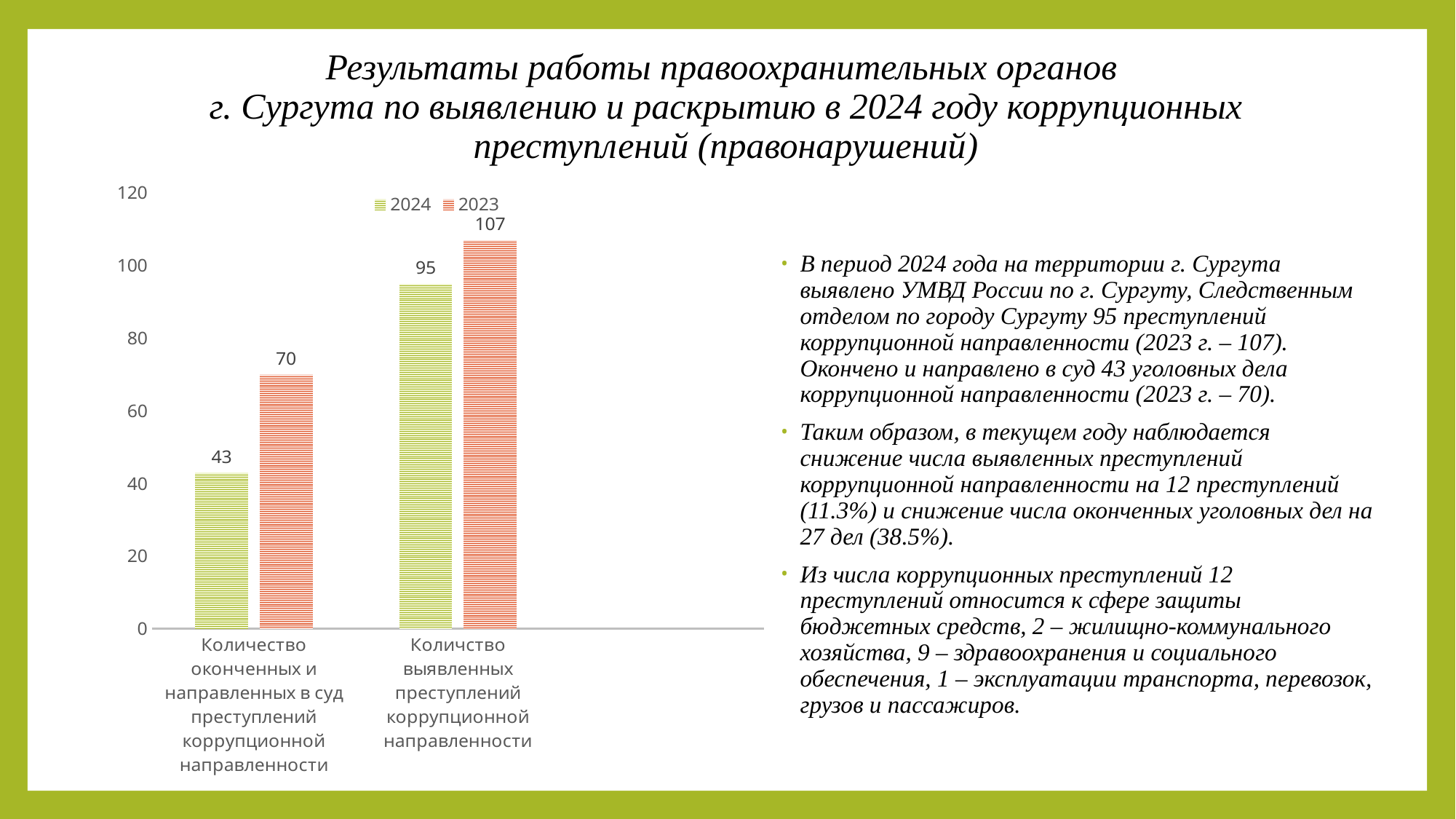
What kind of chart is shown on the slide? Bar chart What is the difference between the 2023 and 2024 values for "Количство выявленных преступлений коррупционной направленности"? 12 Which bar in the chart has the highest value? 2023, Количство выявленных преступлений коррупционной направленности (107) What is the 2023 value for "Количество оконченных и направленных в суд преступлений коррупционной направленности"? 70 Which bar in the chart has the lowest value? 2024, Количество оконченных и направленных в суд преступлений коррупционной направленности (43) What is the 2023 value for "Количство выявленных преступлений коррупционной направленности"? 107 How many series does the legend list? 2 What is the difference between the 2023 and 2024 values for "Количество оконченных и направленных в суд преступлений коррупционной направленности"? 27 What is the 2024 value for "Количство выявленных преступлений коррупционной направленности"? 95 Which series has the higher value for "Количство выявленных преступлений коррупционной направленности", 2024 or 2023? 2023 What is the 2024 value for "Количество оконченных и направленных в суд преступлений коррупционной направленности"? 43 How many categories are shown on the x axis? 2